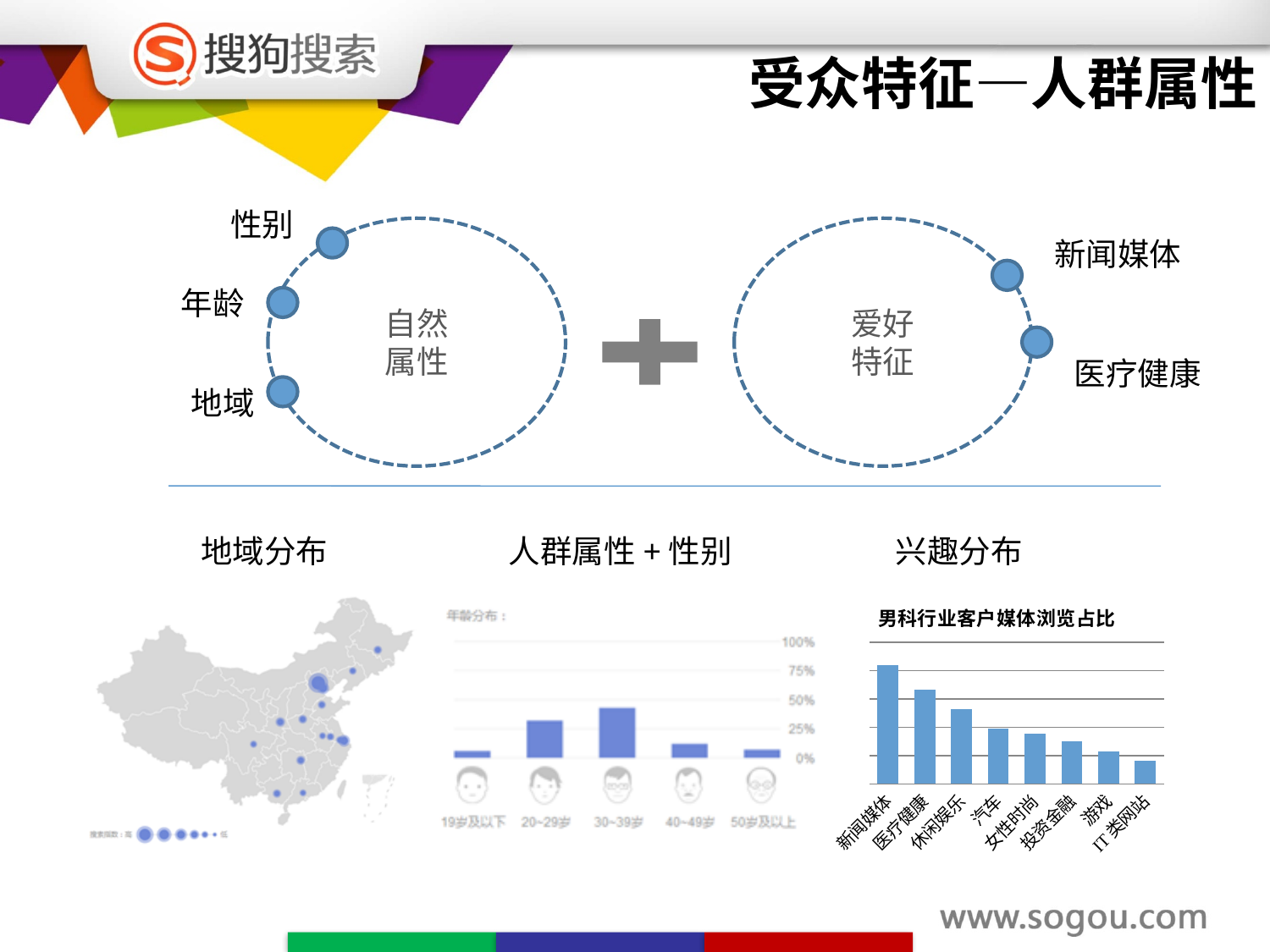
In the chart titled 男科行业客户媒体浏览占比, do the values rise or fall from left to right? fall In the age distribution (年龄分布) chart, how many age groups are shown? 5 In the chart titled 男科行业客户媒体浏览占比, which category comes immediately after 汽车? 女性时尚 In the chart titled 男科行业客户媒体浏览占比, which is larger, 医疗健康 or 休闲娱乐? 医疗健康 In the age distribution (年龄分布) chart, is the value for 30~39岁 greater or less than 25%? greater In the chart titled 男科行业客户媒体浏览占比, which category has the highest value? 新闻媒体 In the age distribution (年龄分布) chart, is the value for 40~49岁 greater or less than 25%? less In the age distribution (年龄分布) chart, which age group has the highest value? 30~39岁 In the chart titled 男科行业客户媒体浏览占比, how many categories are shown? 8 What kind of chart is the one titled 男科行业客户媒体浏览占比? bar chart In the chart titled 男科行业客户媒体浏览占比, which category has the lowest value? IT类网站 What kind of chart is the age distribution (年龄分布) chart in the middle of the slide? bar chart